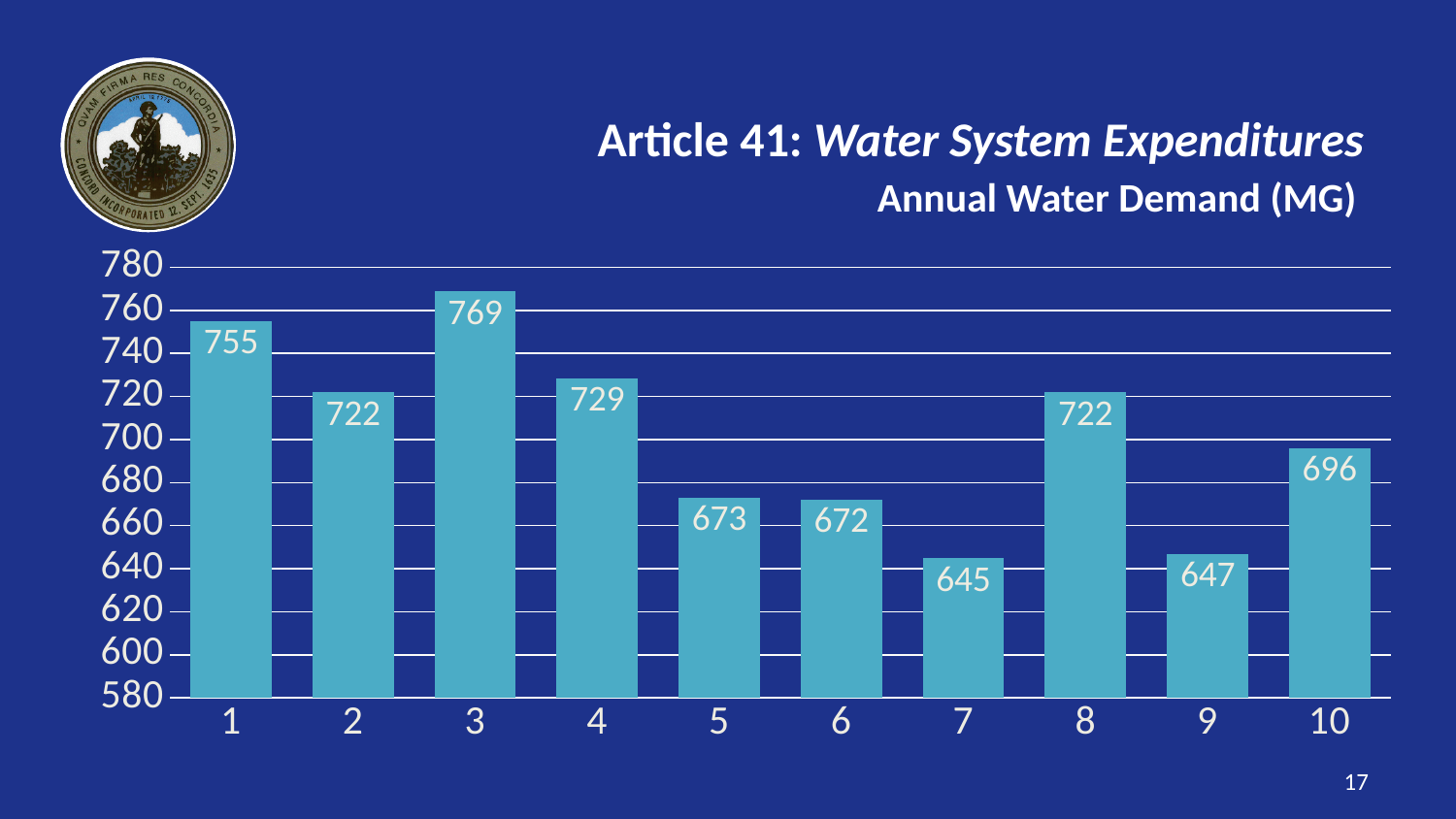
Which has a larger annual water demand, category 4 or category 9? 4 What is the difference between the annual water demand for category 1 and category 7? 110 What is the title of the chart? Annual Water Demand (MG) What is the annual water demand for category 3? 769 What is the annual water demand for category 10? 696 What kind of chart is shown on the slide? bar chart Is the annual water demand for category 10 greater or less than 700? less What is the difference between the annual water demand for category 3 and category 4? 40 Which category has the lowest annual water demand? 7 How many categories are shown on the chart? 10 What is the annual water demand for category 7? 645 Which category has the highest annual water demand? 3